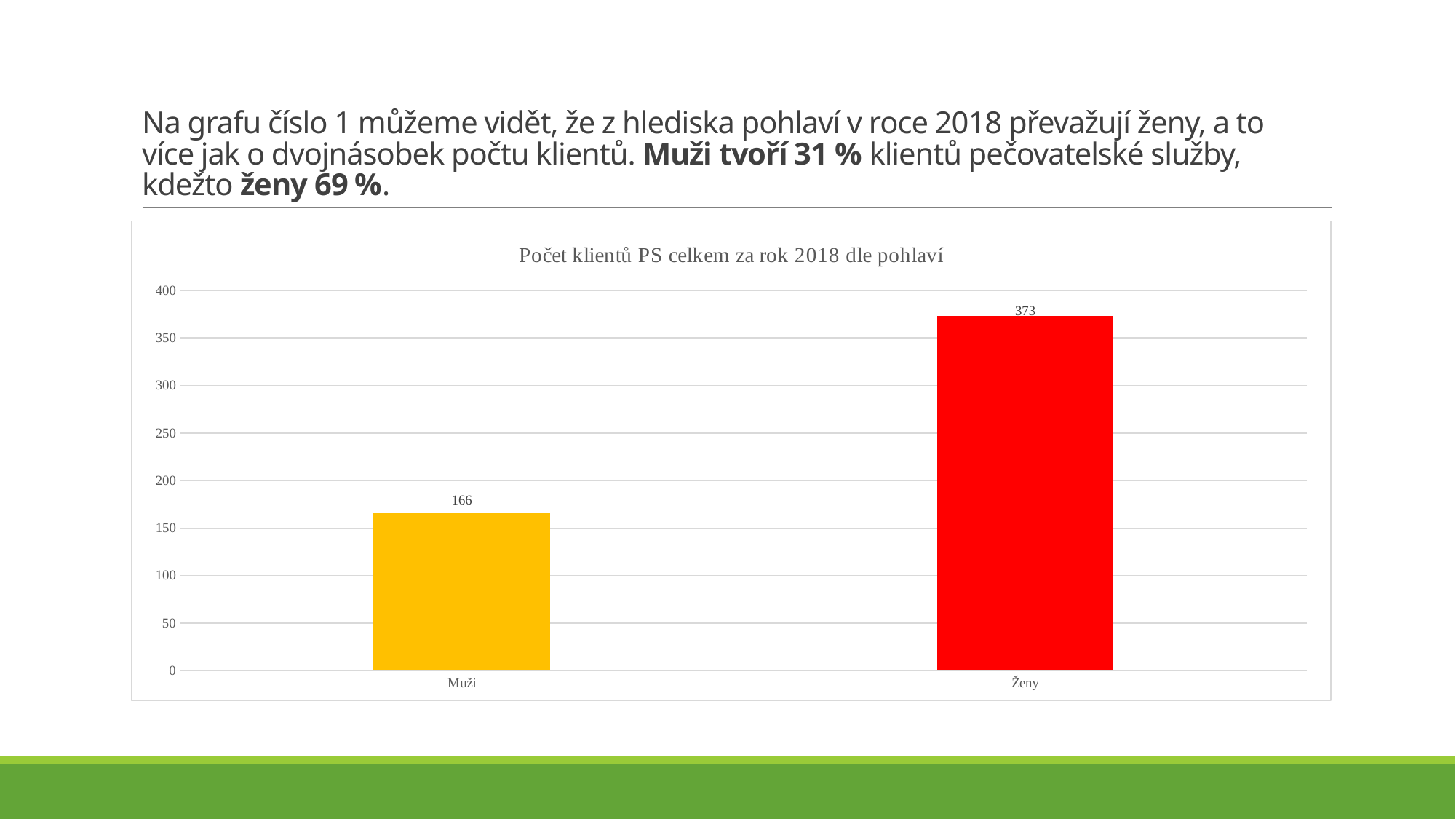
What is the value for Muži? 166 Is the value for Muži greater or less than 200? less Which category has the lowest value? Muži Which category has the highest value? Ženy What kind of chart is shown on the slide? bar chart What is the title of the chart? Počet klientů PS celkem za rok 2018 dle pohlaví Which is larger, the value for Muži or the value for Ženy? Ženy What is the difference between the values for Ženy and Muži? 207 What is the value for Ženy? 373 How many categories are shown in the chart? 2 What colour is the bar for Ženy? red Is the value for Ženy greater or less than 350? greater